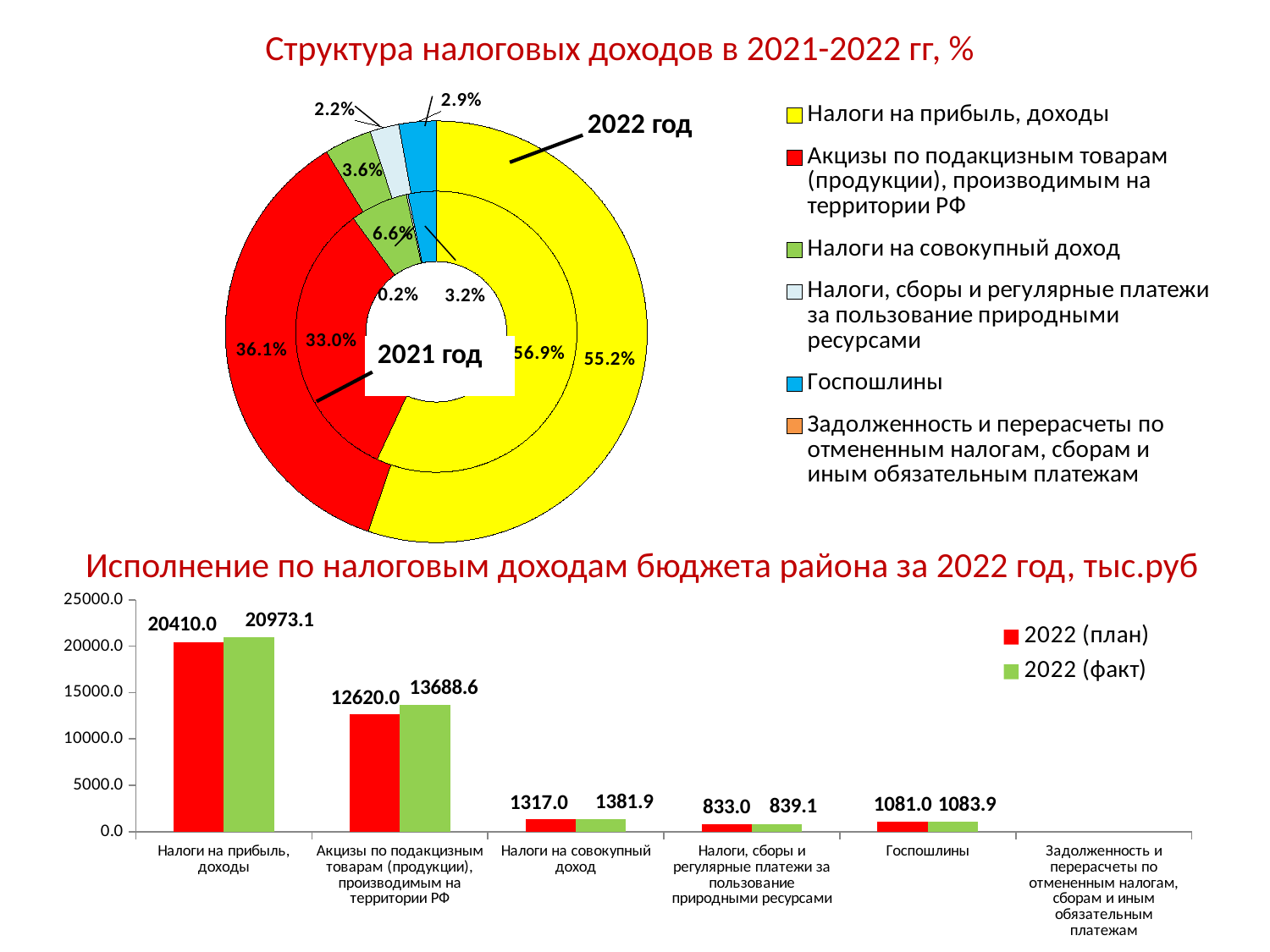
In the doughnut chart 'Структура налоговых доходов в 2021-2022 гг, %', what is the share of 'Налоги на прибыль, доходы' in 2022? 55.2% In the bar chart 'Исполнение по налоговым доходам бюджета района за 2022 год, тыс.руб', what is the 2022 (факт) value for 'Госпошлины'? 1083.9 In the doughnut chart 'Структура налоговых доходов в 2021-2022 гг, %', what is the share of 'Акцизы по подакцизным товарам (продукции), производимым на территории РФ' in 2021? 33.0% In the bar chart 'Исполнение по налоговым доходам бюджета района за 2022 год, тыс.руб', what is the 2022 (факт) value for 'Акцизы по подакцизным товарам (продукции), производимым на территории РФ'? 13688.6 How many entries does the legend of the doughnut chart 'Структура налоговых доходов в 2021-2022 гг, %' list? 6 In the doughnut chart 'Структура налоговых доходов в 2021-2022 гг, %', which category has the largest share in 2022? Налоги на прибыль, доходы What type of chart is the bottom chart 'Исполнение по налоговым доходам бюджета района за 2022 год, тыс.руб'? Bar chart In the bar chart 'Исполнение по налоговым доходам бюджета района за 2022 год, тыс.руб', which is larger for 'Налоги на совокупный доход': the 2022 (план) or the 2022 (факт) value? 2022 (факт) How many series does the legend of the bar chart 'Исполнение по налоговым доходам бюджета района за 2022 год, тыс.руб' list? 2 In the bar chart 'Исполнение по налоговым доходам бюджета района за 2022 год, тыс.руб', by how much does the 2022 (факт) value exceed the 2022 (план) value for 'Налоги на прибыль, доходы'? 563.1 In the bar chart 'Исполнение по налоговым доходам бюджета района за 2022 год, тыс.руб', what is the 2022 (план) value for 'Налоги на прибыль, доходы'? 20410.0 In the bar chart 'Исполнение по налоговым доходам бюджета района за 2022 год, тыс.руб', which category has the highest 2022 (факт) value? Налоги на прибыль, доходы